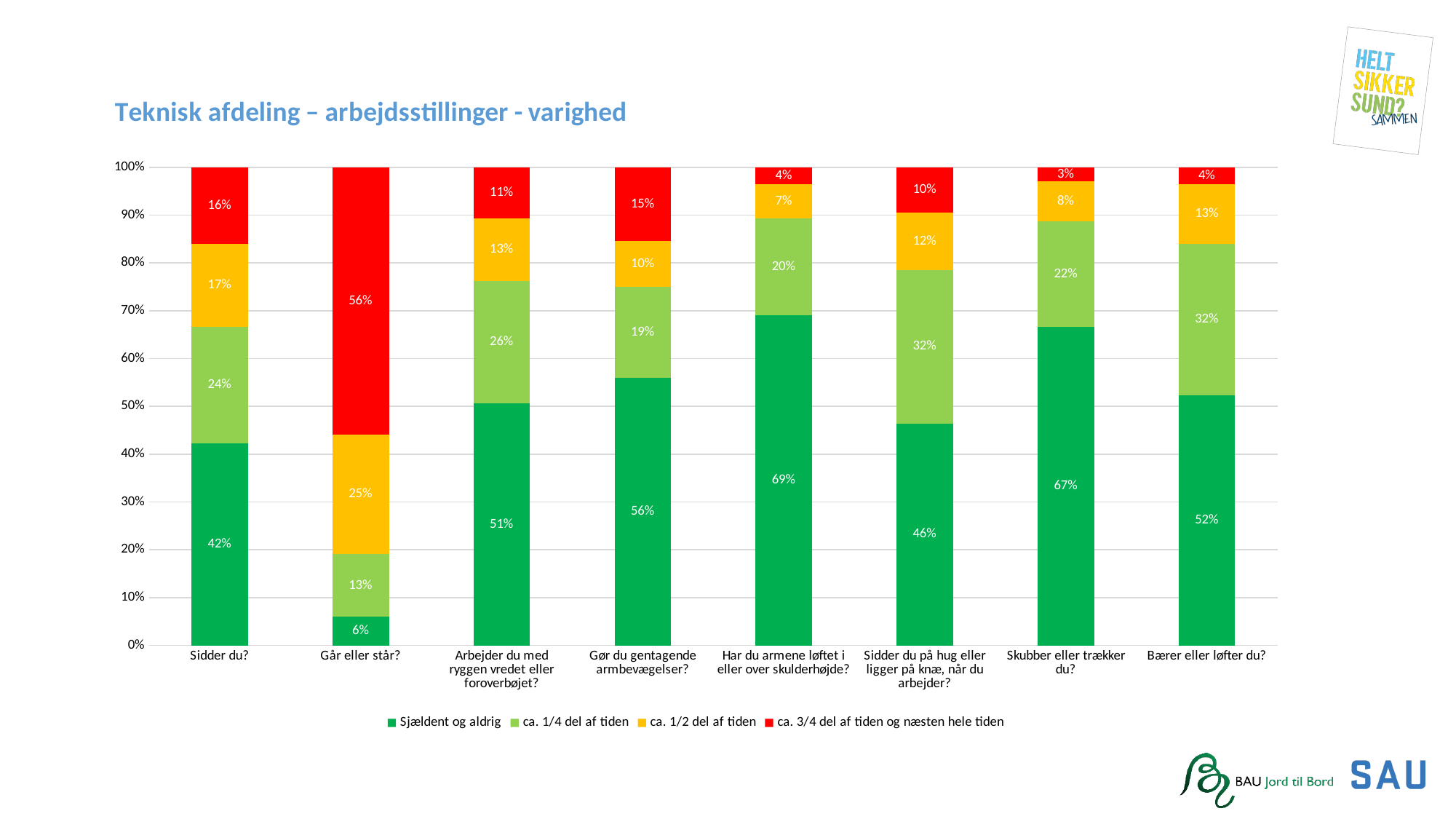
What is the title of the chart? Teknisk afdeling – arbejdsstillinger - varighed How many series does the legend list? 4 Which is larger: the 'ca. 1/4 del af tiden' value for 'Sidder du på hug eller ligger på knæ, når du arbejder?' or for 'Gør du gentagende armbevægelser?'? Sidder du på hug eller ligger på knæ, når du arbejder? Which category has the highest value for 'Sjældent og aldrig'? Har du armene løftet i eller over skulderhøjde? What is the value of 'ca. 3/4 del af tiden og næsten hele tiden' for 'Sidder du?'? 16% What is the total of the stacked bar for 'Bærer eller løfter du?'? 100% What is the difference between the 'Sjældent og aldrig' values for 'Skubber eller trækker du?' and 'Sidder du?'? 25% What is the value of 'Sjældent og aldrig' for 'Går eller står?'? 6% Which category has the lowest value for 'ca. 3/4 del af tiden og næsten hele tiden'? Skubber eller trækker du? How many categories (questions) are shown along the x axis? 8 What kind of chart is shown on the slide? Stacked bar chart What is the value of 'ca. 1/2 del af tiden' for 'Skubber eller trækker du?'? 8%